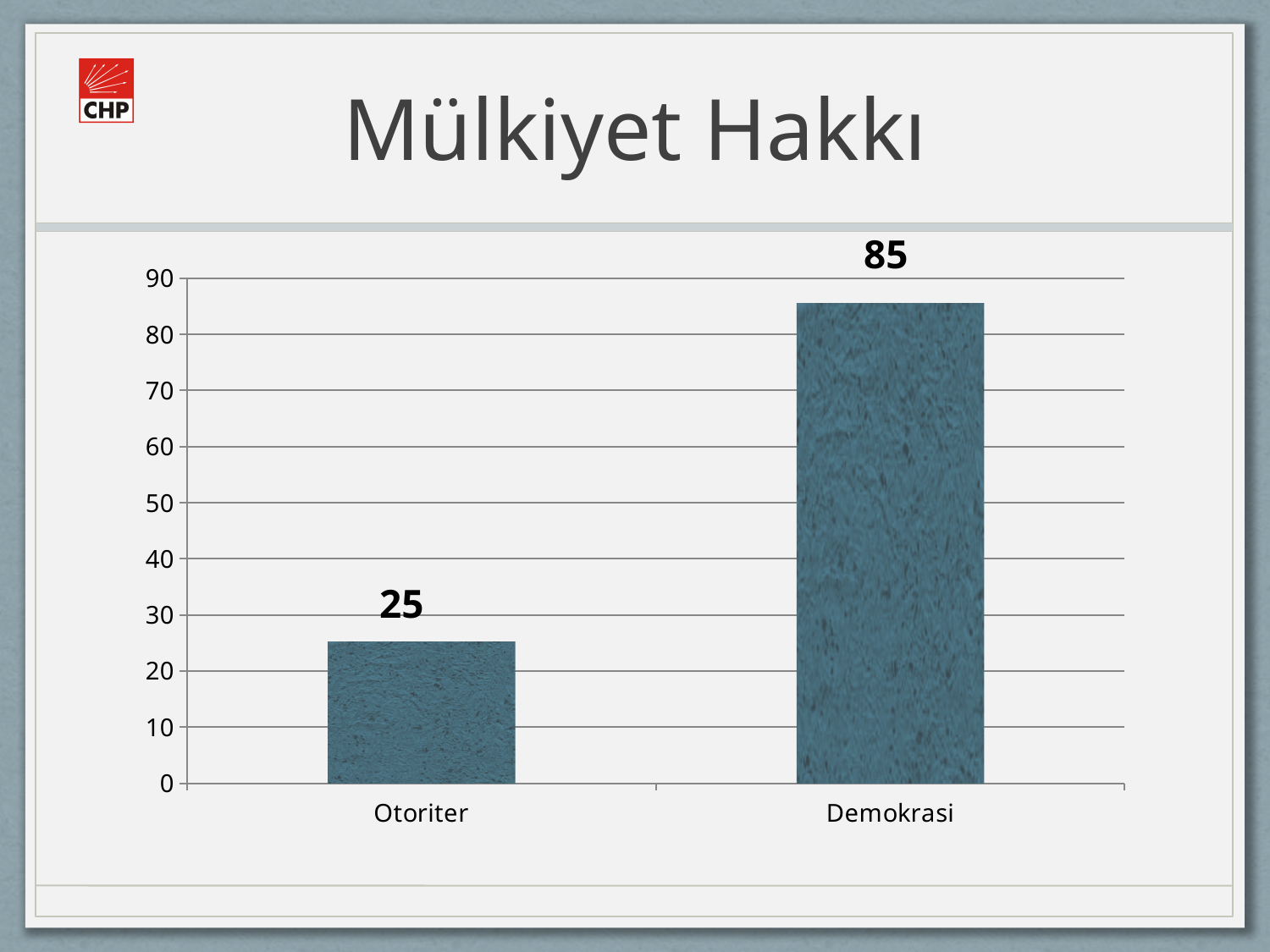
How many categories are shown on the chart? 2 Which category has the highest value? Demokrasi Is the value for Demokrasi greater or less than 80? greater Which is larger, the value for Otoriter or the value for Demokrasi? Demokrasi What is the title of the slide? Mülkiyet Hakkı What is the value for Otoriter? 25 What is the highest value shown on the vertical axis? 90 What is the difference between the values for Demokrasi and Otoriter? 60 Which category has the lowest value? Otoriter Is the value for Otoriter greater or less than 30? less What is the value for Demokrasi? 85 What kind of chart is shown on the slide? bar chart